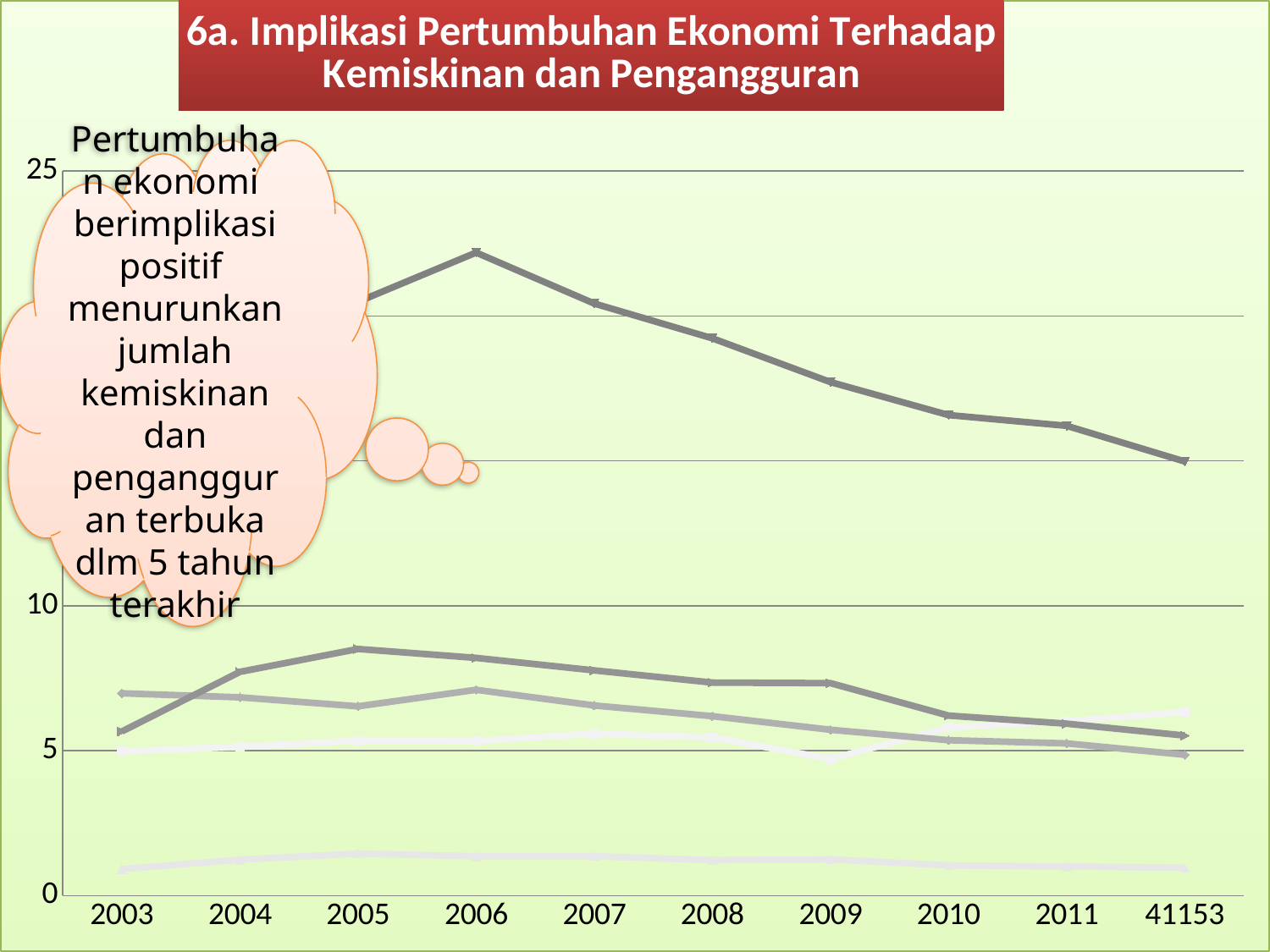
What is the last category label on the x axis? 41153 At which x-axis category is the topmost line at its lowest point? 41153 Does the topmost line rise or fall from 2006 to the last category? fall What kind of chart is shown on the slide? line chart Is the value of the lowest line in 2006 greater or less than 5? less What is the first category label on the x axis? 2003 Is the value of the second-highest line in 2005 greater or less than 10? less Is the value of the second-highest line in 2005 greater or less than 5? greater How many categories are shown on the x axis of the chart? 10 In which year does the topmost line reach its highest point? 2006